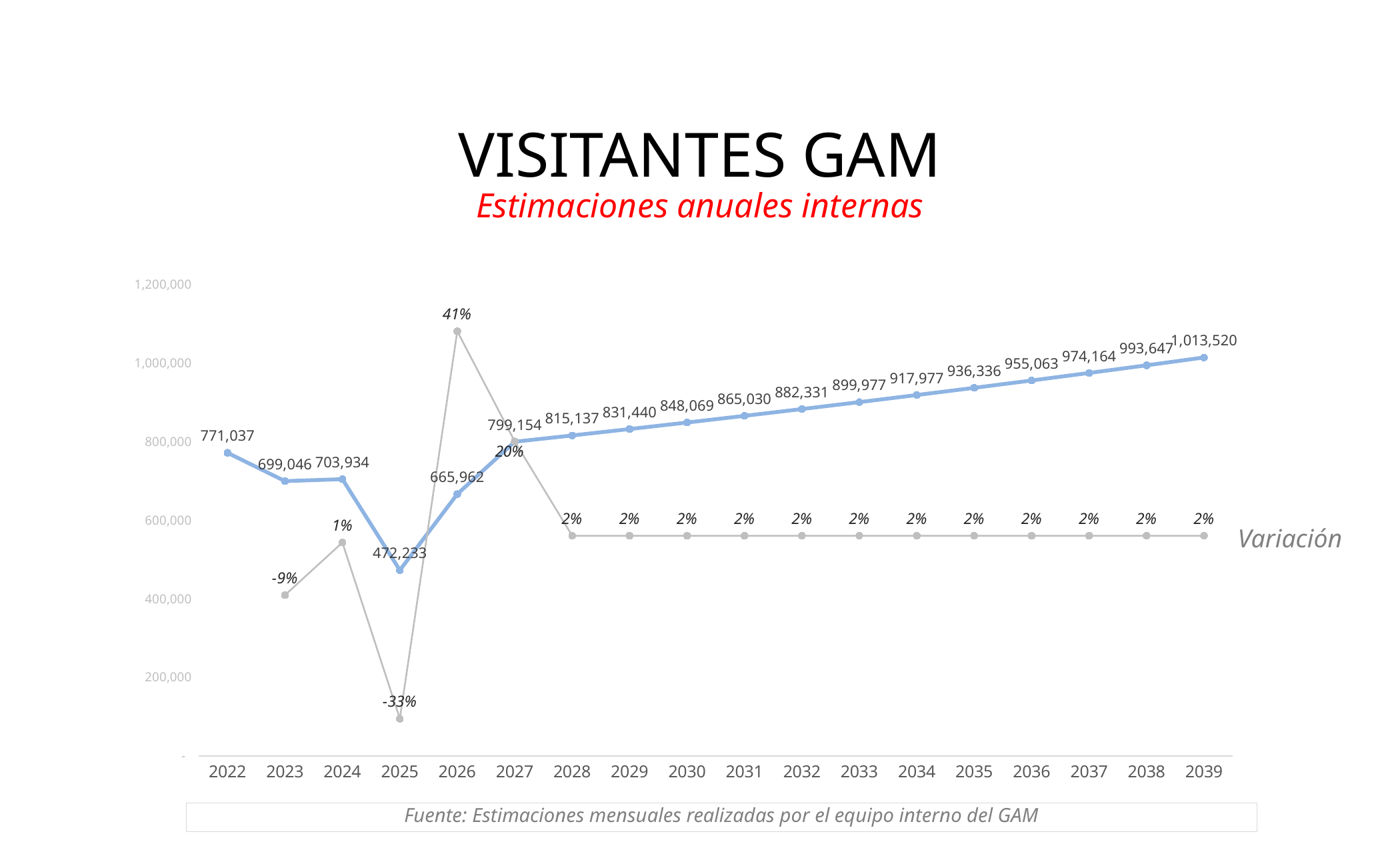
What is the number of visitors estimated for 2039? 1,013,520 Which year has the highest number of visitors? 2039 How many years are shown on the x axis? 18 What is the number of visitors for 2022? 771,037 What is the difference in visitors between 2022 and 2023? 71,991 Do the visitor values rise or fall from 2027 to 2039? rise Which year has the lowest number of visitors? 2025 What is the Variación value shown for 2025? -33% What kind of chart is shown on the slide? line chart Which year has more visitors, 2024 or 2026? 2024 What is the number of visitors for 2025? 472,233 What is the Variación value shown for 2026? 41%